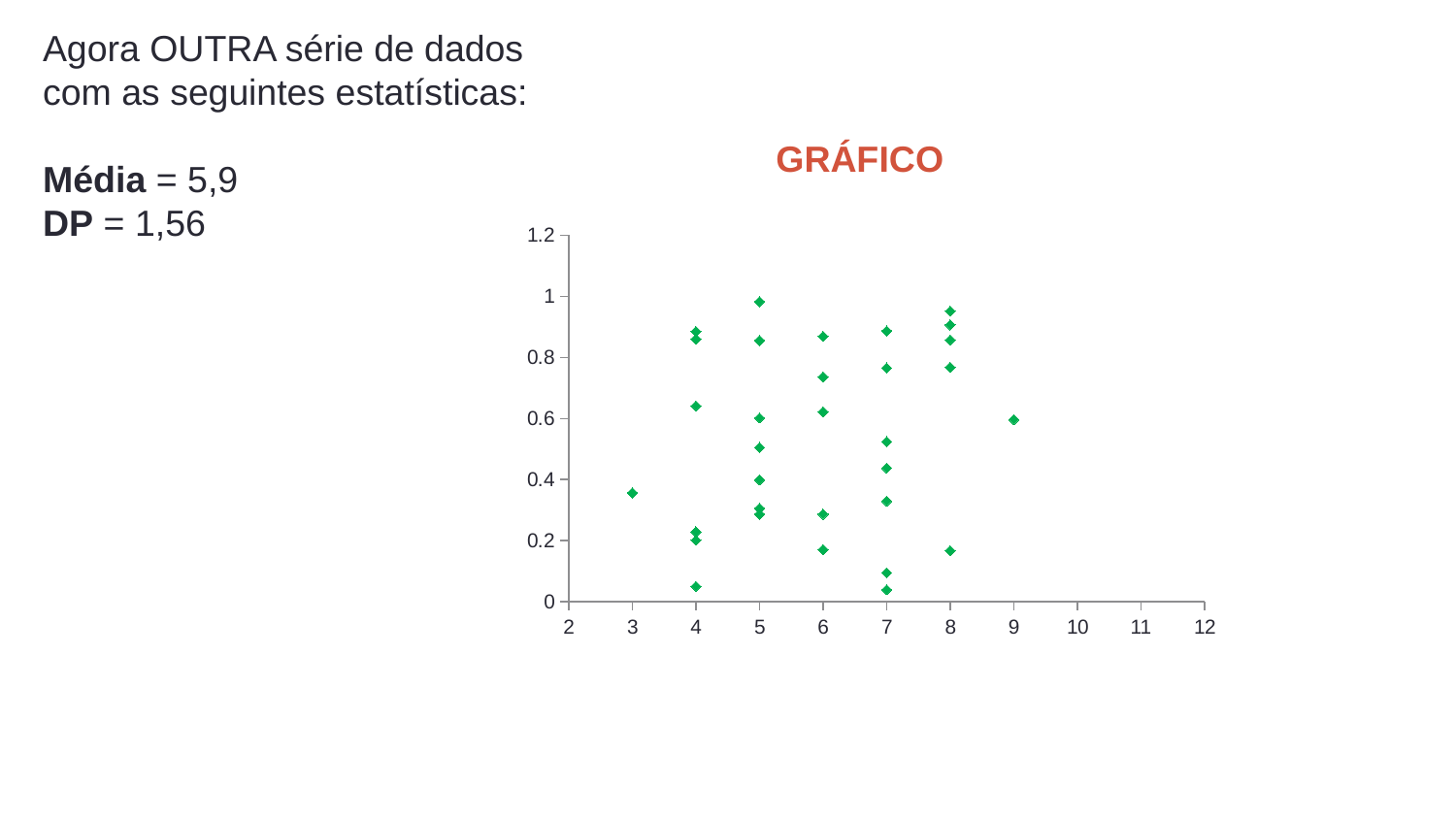
Is the value of the point at x = 3 greater or less than 0.4? less Which x value has more plotted points: x = 4 or x = 9? x = 4 What colour are the data points in the chart? green What is the highest tick value shown on the y axis? 1.2 Is the value of the point at x = 9 greater or less than 0.4? greater What kind of chart is shown on the slide? scatter chart How many data points are plotted at x = 9? 1 Is the lowest point at x = 7 greater or less than 0.2? less What is the title of the chart? GRÁFICO How many data points are plotted at x = 3? 1 Which has the larger y value: the point at x = 3 or the point at x = 9? the point at x = 9